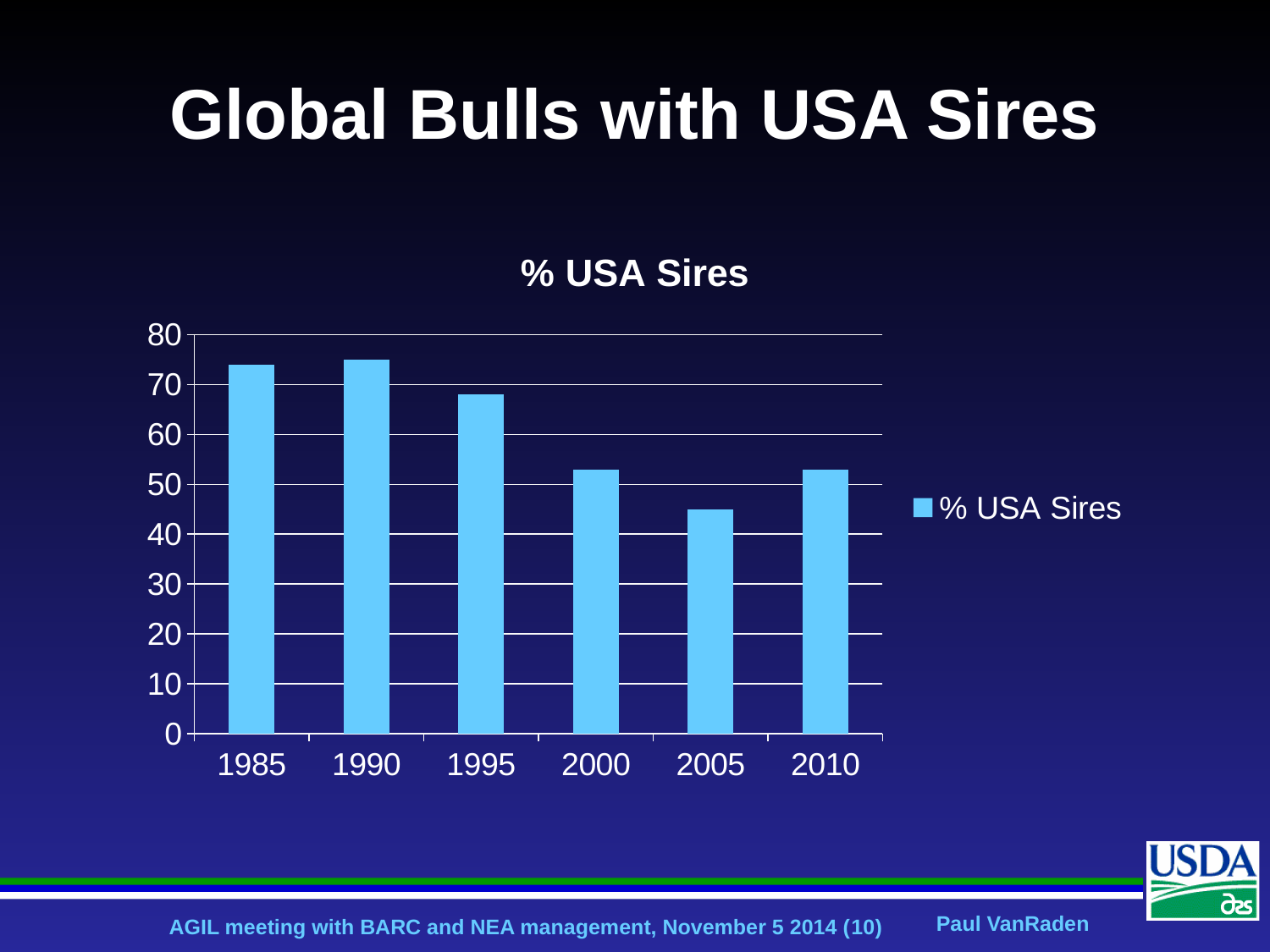
How many series does the legend list? 1 Is the value for 1985 greater or less than 70? greater Which is larger, the value for 1995 or the value for 2000? 1995 Which year has the lowest % USA Sires? 2005 What is the title of the chart? % USA Sires How many years are shown on the x axis? 6 Overall, do the values rise or fall from 1985 to 2005? fall What kind of chart is shown on the slide? bar chart Is the value for 2000 greater or less than 50? greater Is the value for 2005 greater or less than 50? less